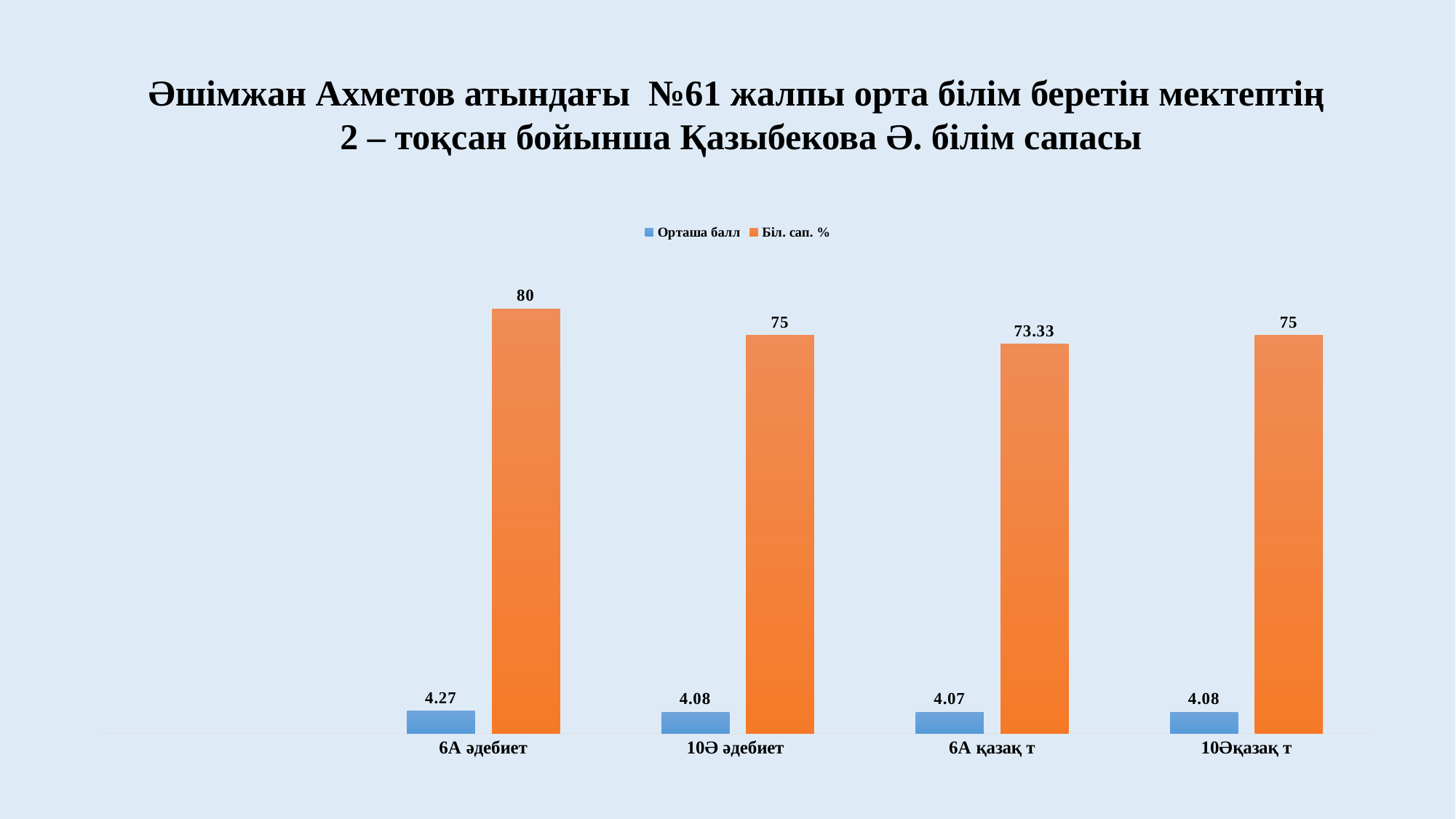
What is the difference between the Біл. сап. % values for 6А әдебиет and 10Ә әдебиет? 5 How many categories are shown on the x axis? 4 What is the Орташа балл value for 10Ә әдебиет? 4.08 Which category has the highest Орташа балл value? 6А әдебиет Which category has the highest Біл. сап. % value? 6А әдебиет How many series does the legend list? 2 What is the difference between the Орташа балл values for 6А әдебиет and 6А қазақ т? 0.2 What is the Біл. сап. % value for 6А әдебиет? 80 What kind of chart is shown on the slide? Bar chart Which category has the lowest Біл. сап. % value? 6А қазақ т What is the Орташа балл value for 6А қазақ т? 4.07 What is the Біл. сап. % value for 6А қазақ т? 73.33